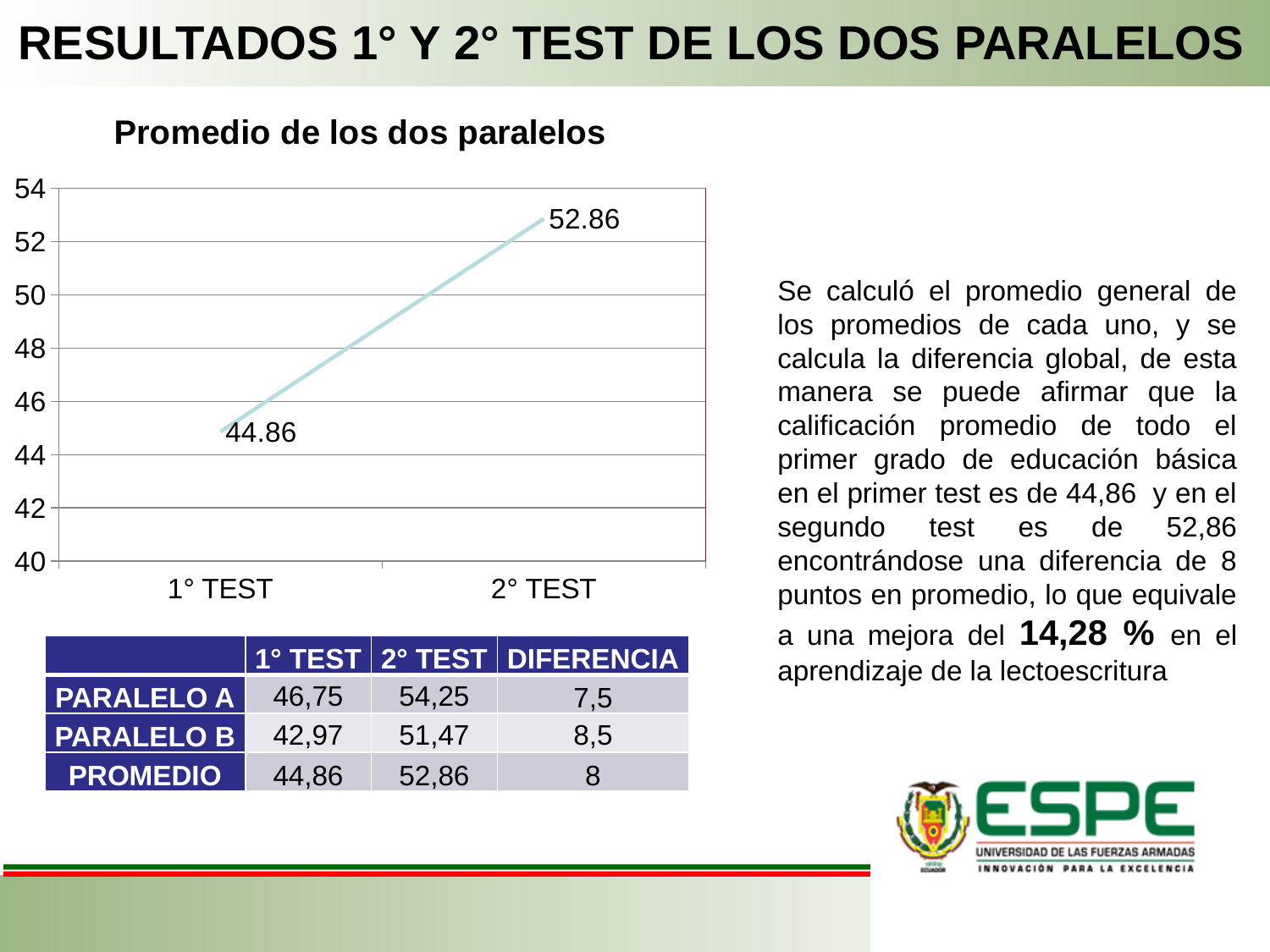
Which is larger, the value for 1° TEST or the value for 2° TEST? 2° TEST What is the value for 1° TEST in the chart? 44.86 How many categories are shown on the x axis of the chart? 2 What is the value for 2° TEST in the chart? 52.86 Do the values rise or fall from 1° TEST to 2° TEST? rise What is the title of the chart? Promedio de los dos paralelos Which category has the lowest value in the chart? 1° TEST Is the value for 2° TEST greater or less than 52? greater What kind of chart is shown on the slide? line chart Is the value for 1° TEST greater or less than 46? less What is the difference between the values for 2° TEST and 1° TEST? 8 Which category has the highest value in the chart? 2° TEST